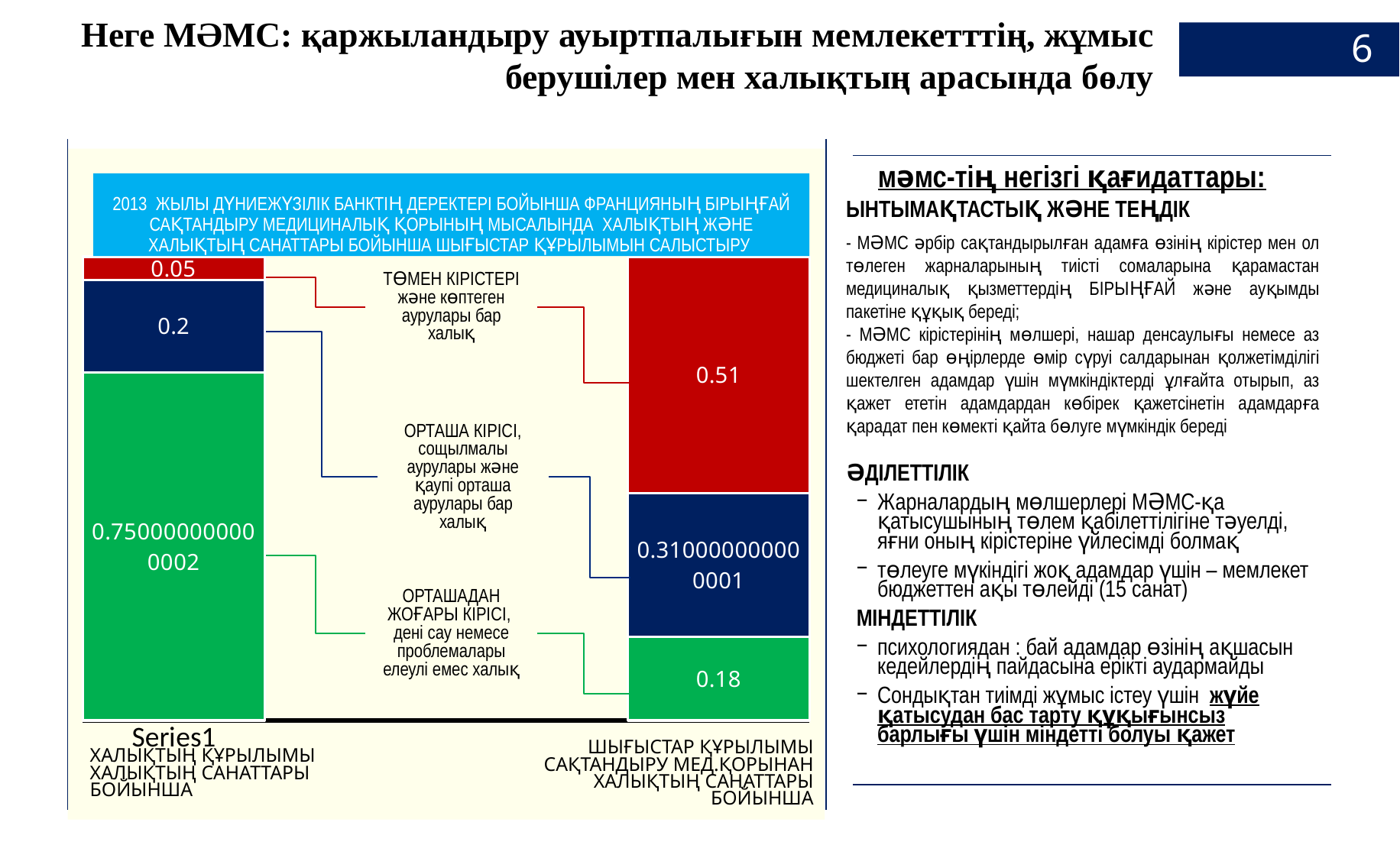
What is the difference between the red segment (0.51) and the green segment (0.18) of the right bar? 0.33 What is the value of the green (bottom) segment of the right bar (ШЫҒЫСТАР ҚҰРЫЛЫМЫ)? 0.18 Which segment of the right bar (ШЫҒЫСТАР ҚҰРЫЛЫМЫ) has the largest value? the red segment (0.51) What is the value of the red (top) segment of the right bar (ШЫҒЫСТАР ҚҰРЫЛЫМЫ)? 0.51 What is the value of the red (top) segment of the left bar (ХАЛЫҚТЫҢ ҚҰРЫЛЫМЫ)? 0.05 What is the value of the green (bottom) segment of the left bar (ХАЛЫҚТЫҢ ҚҰРЫЛЫМЫ)? 0.750000000000002 What is the value of the dark blue (middle) segment of the right bar (ШЫҒЫСТАР ҚҰРЫЛЫМЫ)? 0.310000000000001 Which colour represents the low-income group with many diseases (ТӨМЕН КІРІСТЕРІ) in the chart? red What is the value of the dark blue (middle) segment of the left bar (ХАЛЫҚТЫҢ ҚҰРЫЛЫМЫ)? 0.2 How many stacked bars does the chart contain? 2 Which is larger: the red segment of the left bar or the red segment of the right bar? the red segment of the right bar What kind of chart is shown on the left of the slide? stacked bar chart